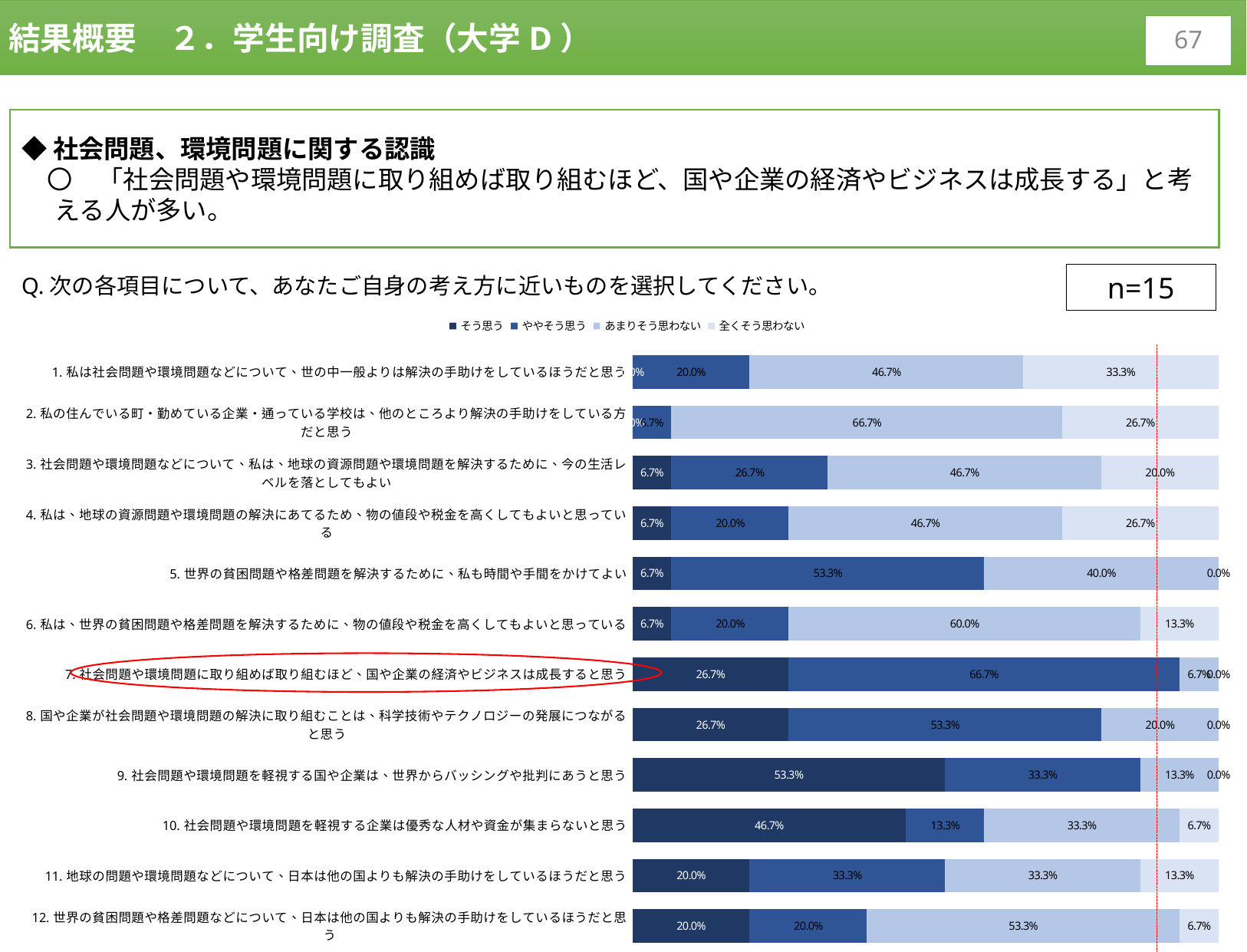
What is the 「ややそう思う」 value for item 7 (社会問題や環境問題に取り組めば取り組むほど、国や企業の経済やビジネスは成長すると思う)? 66.7% What is the difference between the 「あまりそう思わない」 value for item 6 (60.0%) and the 「あまりそう思わない」 value for item 5 (40.0%)? 20.0% What is the 「全くそう思わない」 value for item 1 (私は社会問題や環境問題などについて、世の中一般よりは解決の手助けをしているほうだと思う)? 33.3% What is the 「あまりそう思わない」 value for item 2 (私の住んでいる町・勤めている企業・通っている学校は、他のところより解決の手助けをしている方だと思う)? 66.7% How many items (categories) are plotted in the chart? 12 Which is larger: the 「そう思う」 value for item 10 or the 「そう思う」 value for item 11? Item 10 What is the sample size (n) shown for this chart? n=15 How many series does the chart legend list? 4 What is the 「そう思う」 value for item 9 (社会問題や環境問題を軽視する国や企業は、世界からバッシングや批判にあうと思う)? 53.3% Which legend entry is listed first in the chart legend? そう思う What kind of chart is shown on the slide? Stacked bar chart Which item has the highest 「そう思う」 share? 9. 社会問題や環境問題を軽視する国や企業は、世界からバッシングや批判にあうと思う